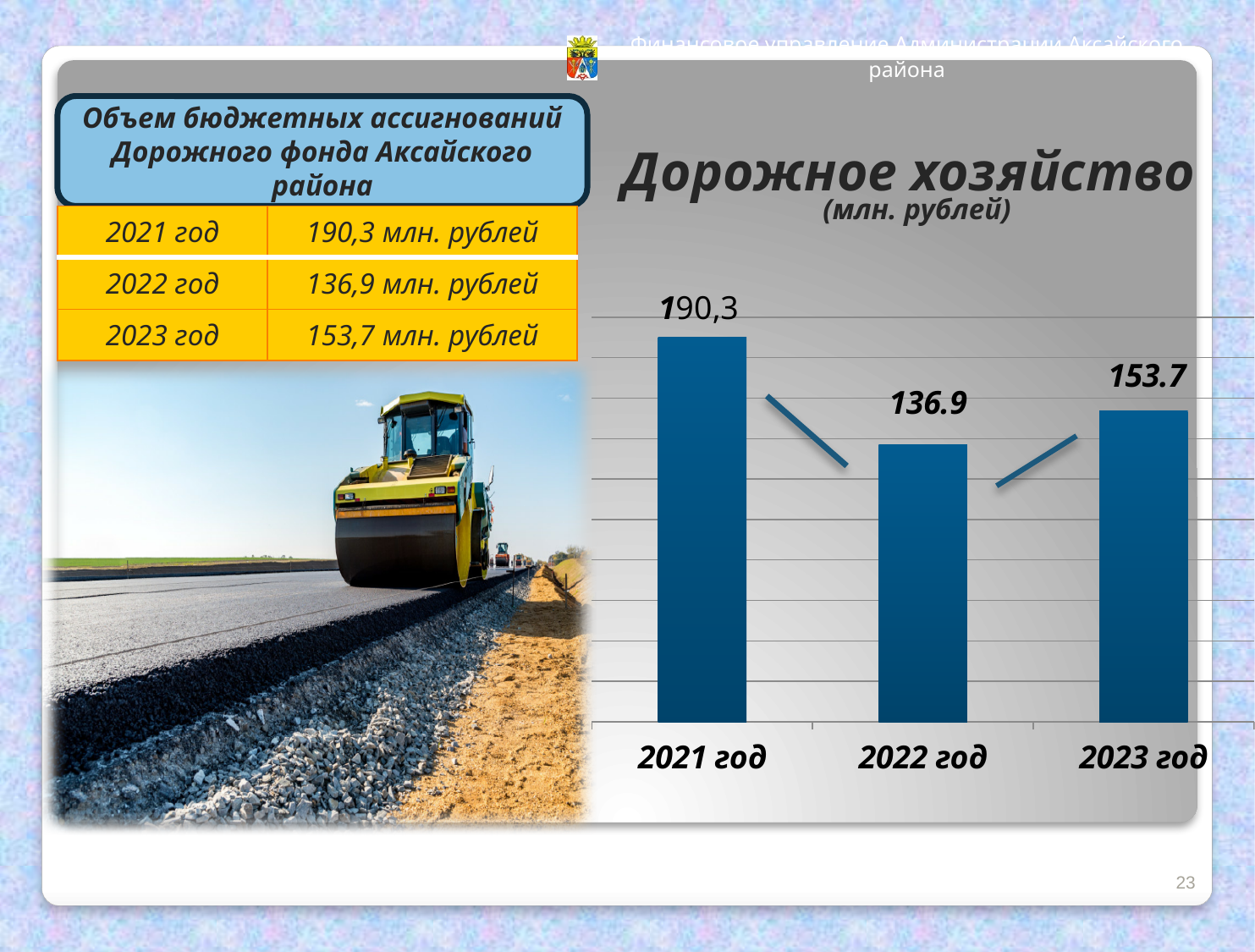
What kind of chart is shown on the slide? bar chart What is the difference between the values for 2023 год and 2022 год? 16.8 What is the value for 2022 год in the chart? 136.9 What unit is given under the chart title? млн. рублей What is the value for 2021 год in the chart? 190,3 Does the value rise or fall from 2021 год to 2022 год? fall What is the value for 2023 год in the chart? 153.7 Which year has the highest value in the chart? 2021 год How many bars are in the chart? 3 What is the title of the chart? Дорожное хозяйство Which year has the lowest value in the chart? 2022 год Which is larger, the value for 2023 год or the value for 2022 год? 2023 год